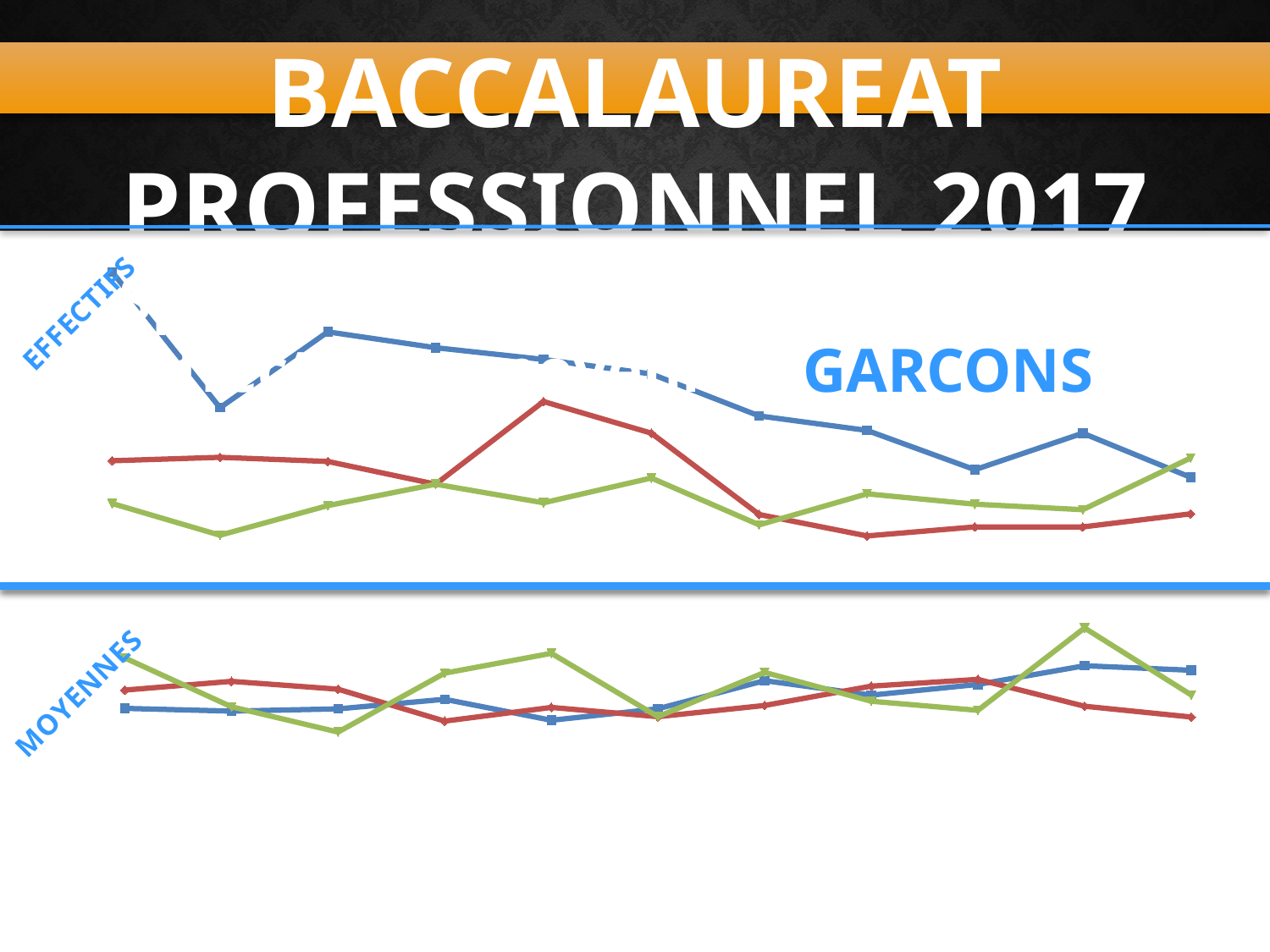
What is the title of the bottom chart on the slide? MOYENNES On the EFFECTIFS chart, does the blue line rise or fall overall from left to right? Fall How many lines are plotted on the MOYENNES chart? 3 On the EFFECTIFS chart, does the green line rise or fall overall from left to right? Rise What kind of chart is the MOYENNES chart at the bottom of the slide? Line chart How many data points does each line on the MOYENNES chart have? 11 On the EFFECTIFS chart, which line is highest at the first point on the left? The blue line What is the title of the top chart on the slide? EFFECTIFS How many lines are plotted on the EFFECTIFS chart? 3 On the EFFECTIFS chart, which line is lowest at the first point on the left? The green line What kind of chart is the EFFECTIFS chart at the top of the slide? Line chart